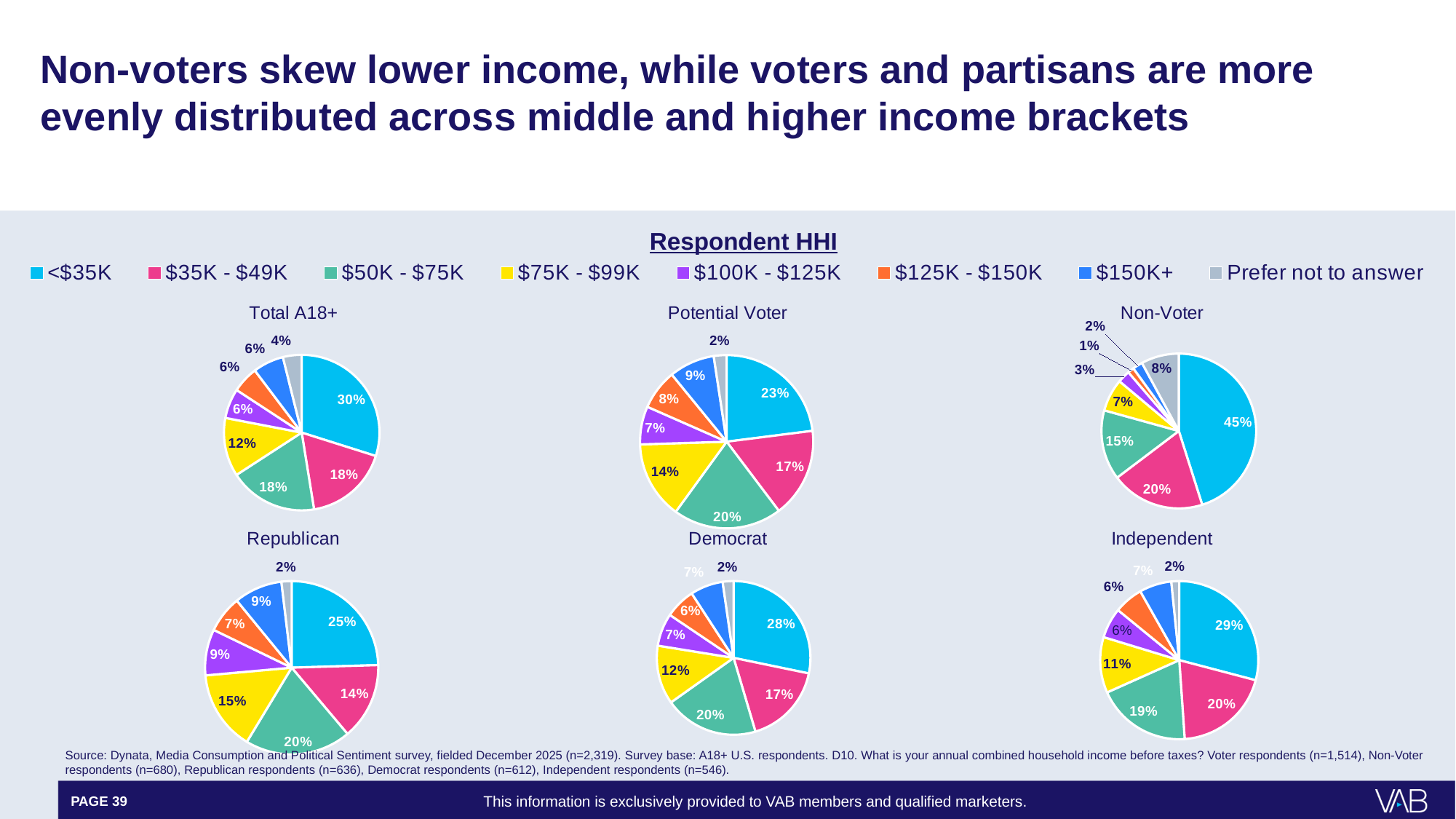
In the Total A18+ pie chart, what percentage of respondents fall in the $75K - $99K bracket? 12% How many income categories does the legend list? 8 In the Non-Voter pie chart, which income bracket has the smallest share? $125K - $150K What is the difference between the <$35K share in the Non-Voter chart and the <$35K share in the Potential Voter chart? 22 percentage points In the Non-Voter pie chart, what share of respondents have a household income of <$35K? 45% Which is larger: the $75K - $99K share in the Republican chart or the $75K - $99K share in the Democrat chart? Republican In the Independent pie chart, what is the value for the $150K+ slice? 7% In the Democrat pie chart, what percentage of respondents have a household income of $50K - $75K? 20% In the Potential Voter pie chart, which income bracket has the largest share? <$35K How many pie charts are shown on the slide? 6 In the Republican pie chart, what is the value for the $35K - $49K slice? 14% What type of chart is used to show Respondent HHI for each group? Pie chart